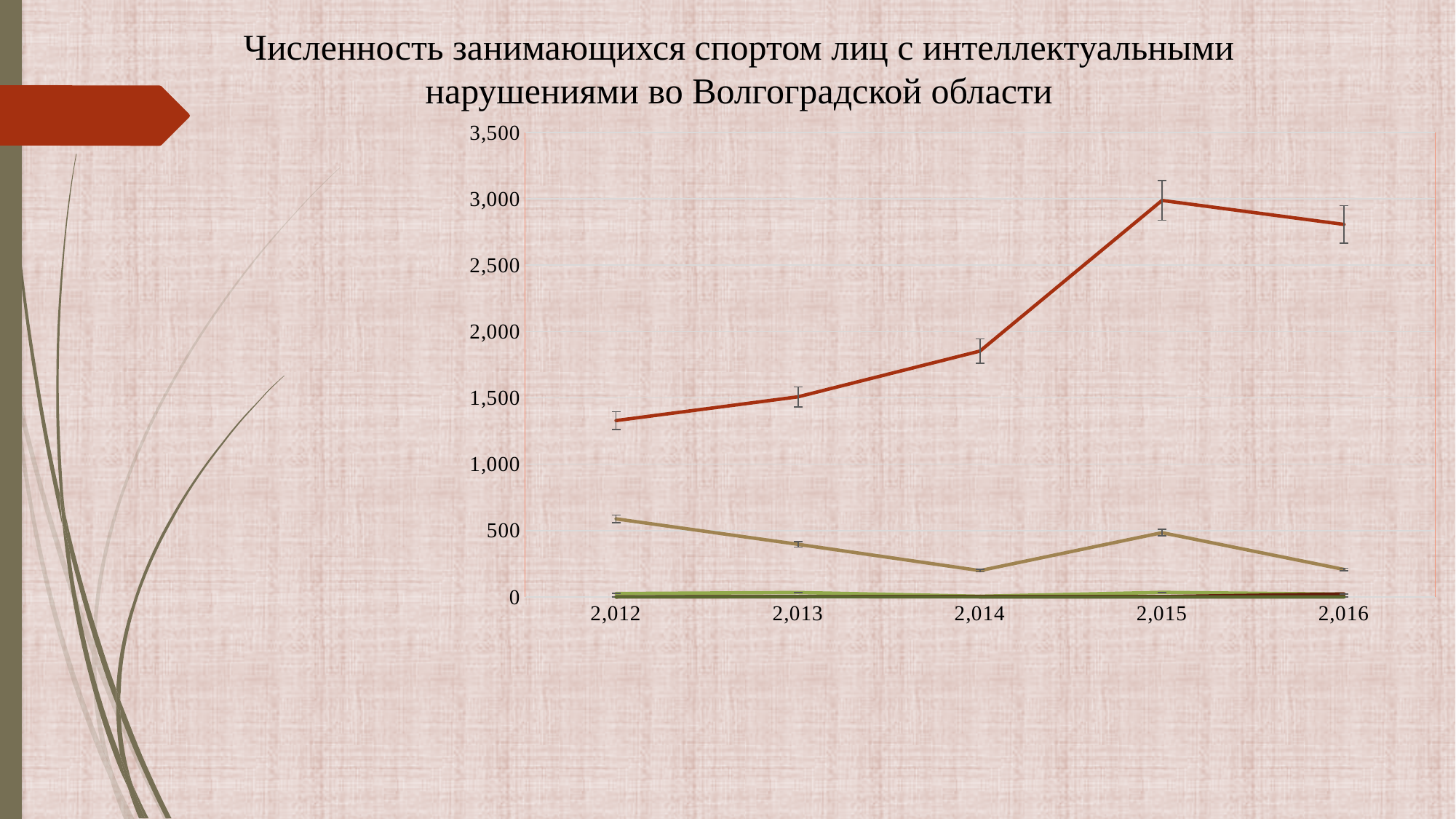
What is the highest value shown on the y axis? 3,500 What is the first year shown on the x axis? 2,012 In 2,014, which line has the larger value, the red line or the tan line? the red line Is the value of the red line in 2,016 greater or less than 3,000? less In which year does the red line reach its highest point? 2,015 Does the red line rise or fall from 2,012 to 2,015? rise In which year is the red line at its lowest point? 2,012 Is the value of the red line in 2,015 greater or less than 2,500? greater Is the value of the red line in 2,012 greater or less than 1,000? greater How many years are shown on the x axis of the chart? 5 What kind of chart is shown on the slide? line chart